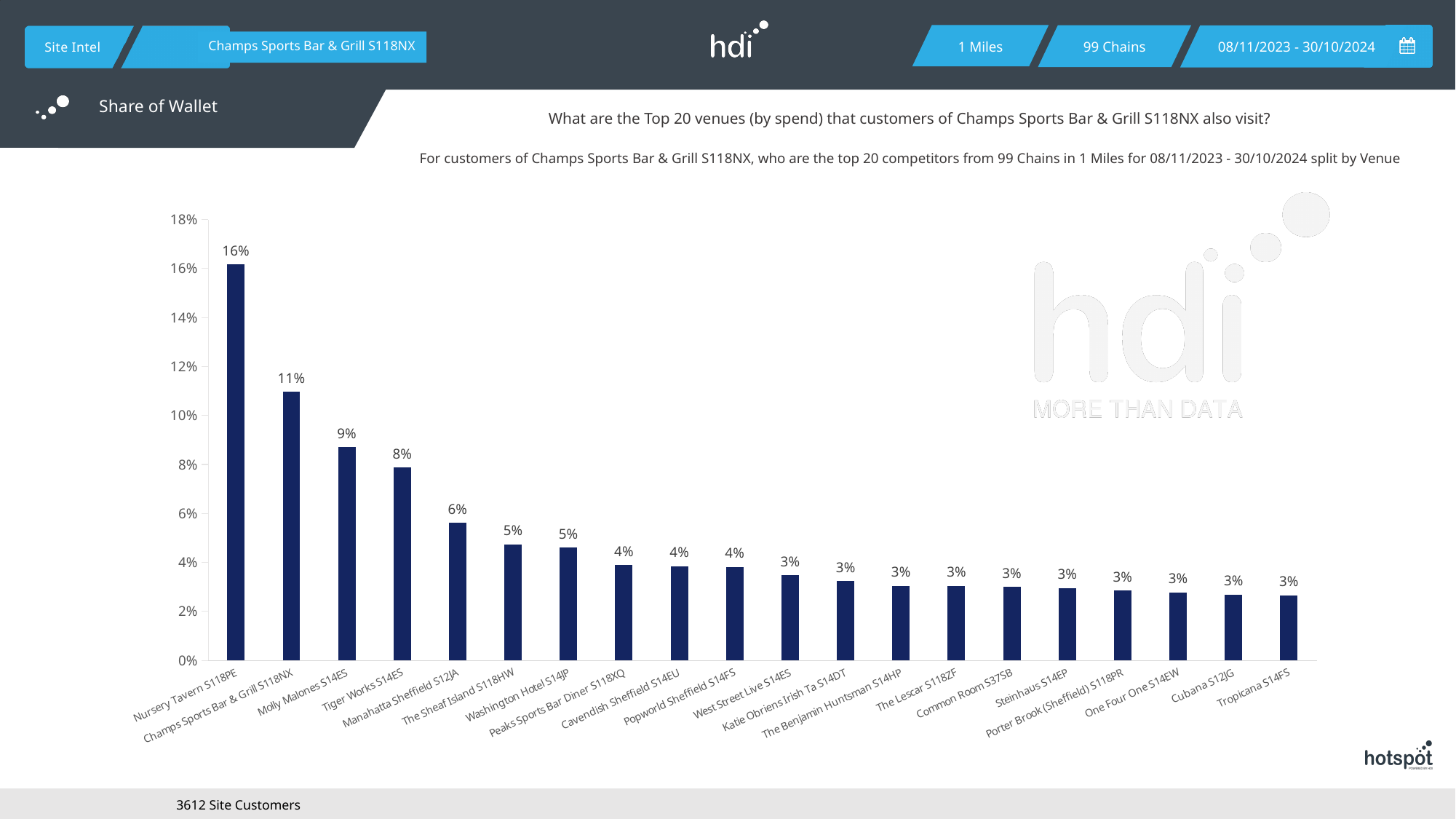
Which is larger, the value for Molly Malones S14ES or the value for Tiger Works S14ES? Molly Malones S14ES What kind of chart is shown on the slide? bar chart What is the value for Champs Sports Bar & Grill S118NX? 11% What is the difference between the values for Nursery Tavern S118PE and Champs Sports Bar & Grill S118NX? 5% What is the value for Nursery Tavern S118PE? 16% Is the value for Nursery Tavern S118PE greater or less than 14%? greater Do the values rise or fall from left to right along the x axis? fall Which venue has the highest value? Nursery Tavern S118PE What is the value for Tiger Works S14ES? 8% Is the value for Manahatta Sheffield S12JA greater or less than 8%? less What is the value for Manahatta Sheffield S12JA? 6% How many venues are plotted on the chart? 20